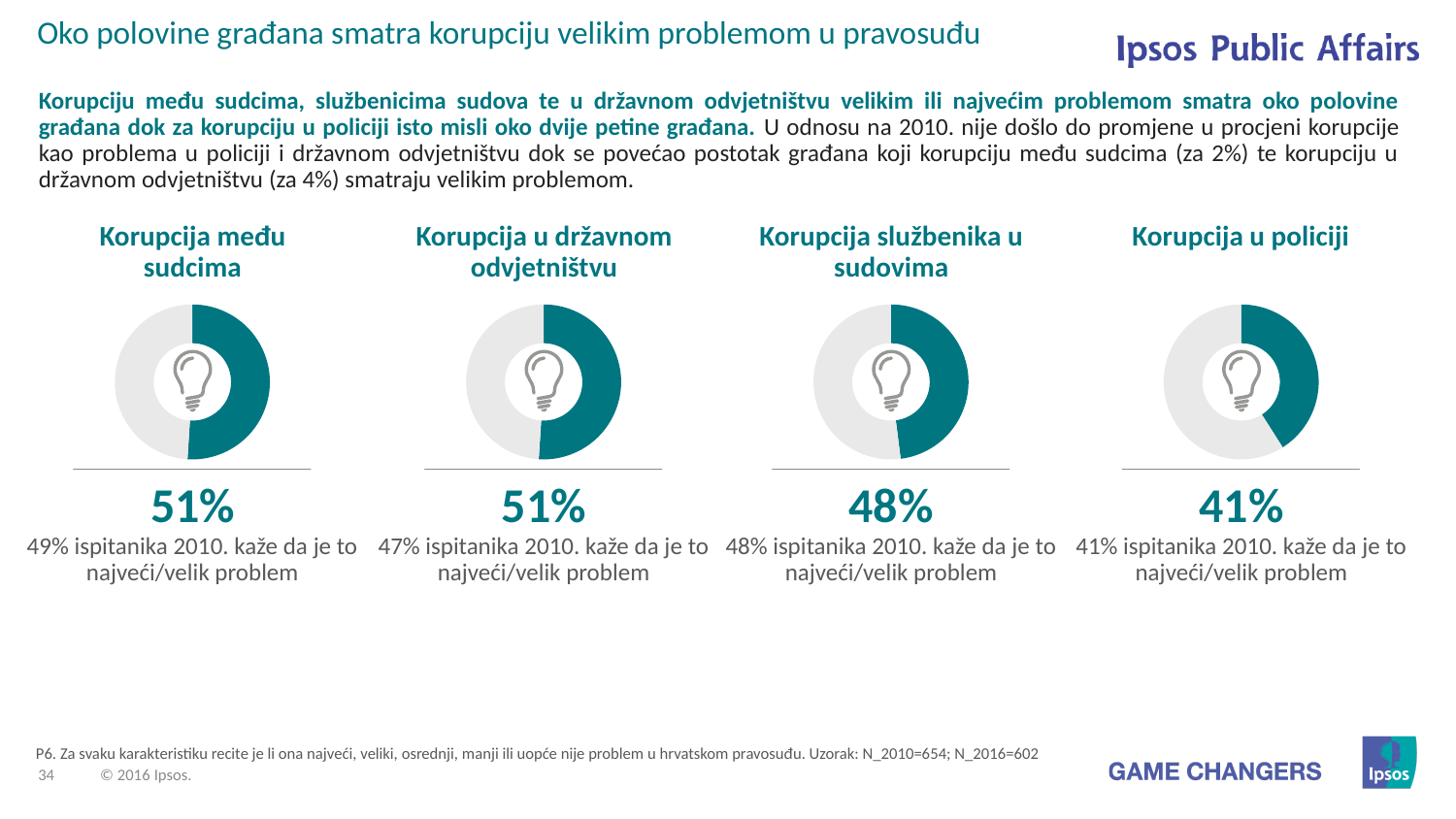
Is the value on the 'Korupcija u policiji' chart greater or less than 50%? less What value is shown on the 'Korupcija u državnom odvjetništvu' chart? 51% What is the difference between the value on the 'Korupcija u državnom odvjetništvu' chart and the value on the 'Korupcija službenika u sudovima' chart? 3% What is the difference between the value on the 'Korupcija među sudcima' chart and the value on the 'Korupcija u policiji' chart? 10% What kind of chart is used for 'Korupcija u policiji'? Donut chart How many donut charts are shown on the slide? 4 What icon appears in the centre of each donut chart? A light bulb Which of the four charts shows the lowest percentage? Korupcija u policiji Which is larger: the value on the 'Korupcija službenika u sudovima' chart or the value on the 'Korupcija u policiji' chart? Korupcija službenika u sudovima What value is shown on the 'Korupcija službenika u sudovima' chart? 48% What value is shown on the 'Korupcija u policiji' chart? 41% What value is shown on the 'Korupcija među sudcima' chart? 51%